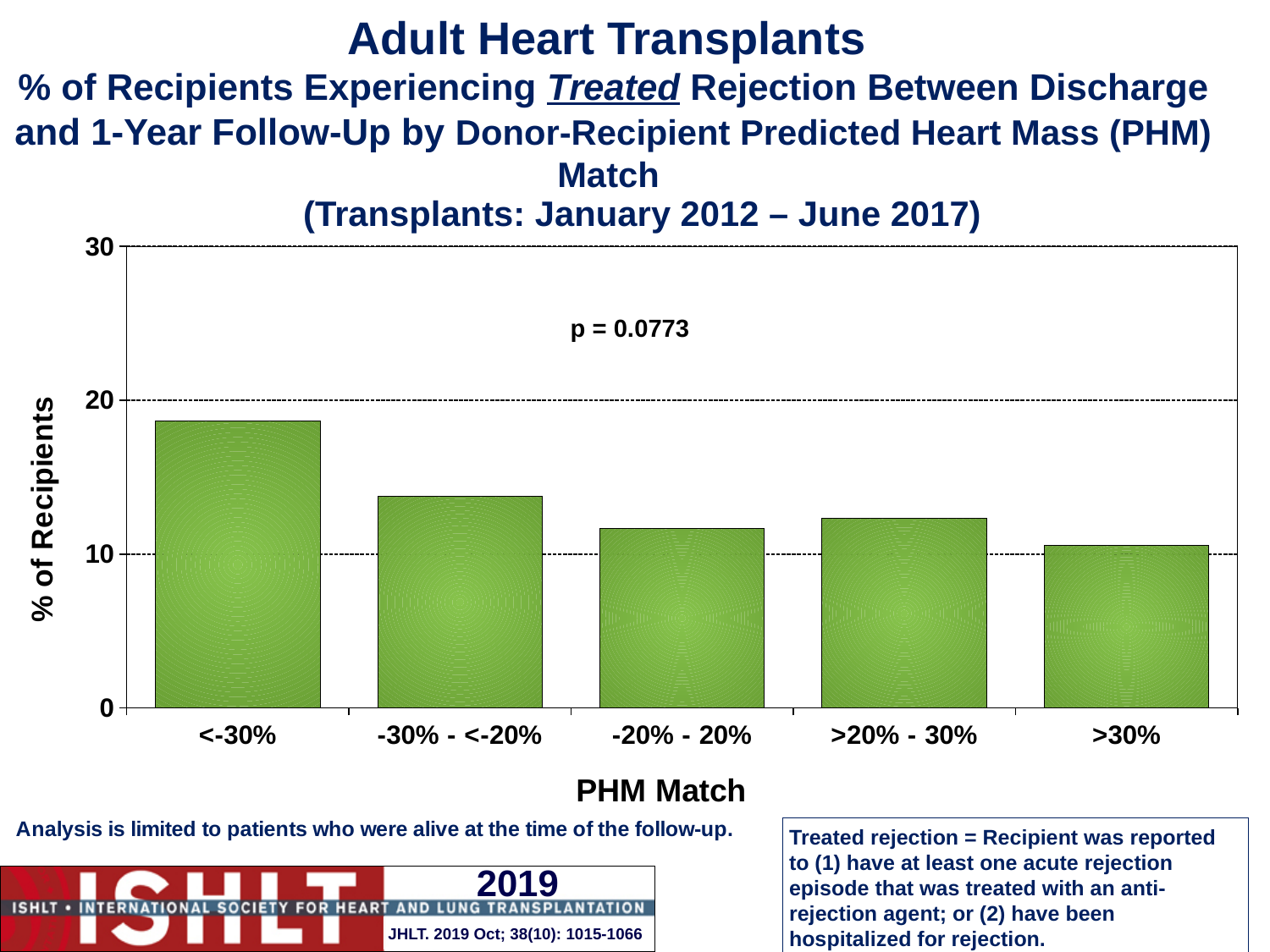
Which has a higher % of recipients: the <-30% category or the >30% category? <-30% Is the value for the -30% - <-20% category greater or less than 10? greater How many PHM Match categories are plotted on the x axis? 5 Is the value for the >20% - 30% category greater or less than 20? less Which has a higher % of recipients: the -30% - <-20% category or the -20% - 20% category? -30% - <-20% What p-value is printed on the chart? p = 0.0773 What kind of chart is shown on the slide? bar chart Which PHM Match category has the lowest % of recipients experiencing treated rejection? >30% Is the value for the <-30% category greater or less than 20? less What is the title of the x axis? PHM Match Which PHM Match category has the highest % of recipients experiencing treated rejection? <-30%